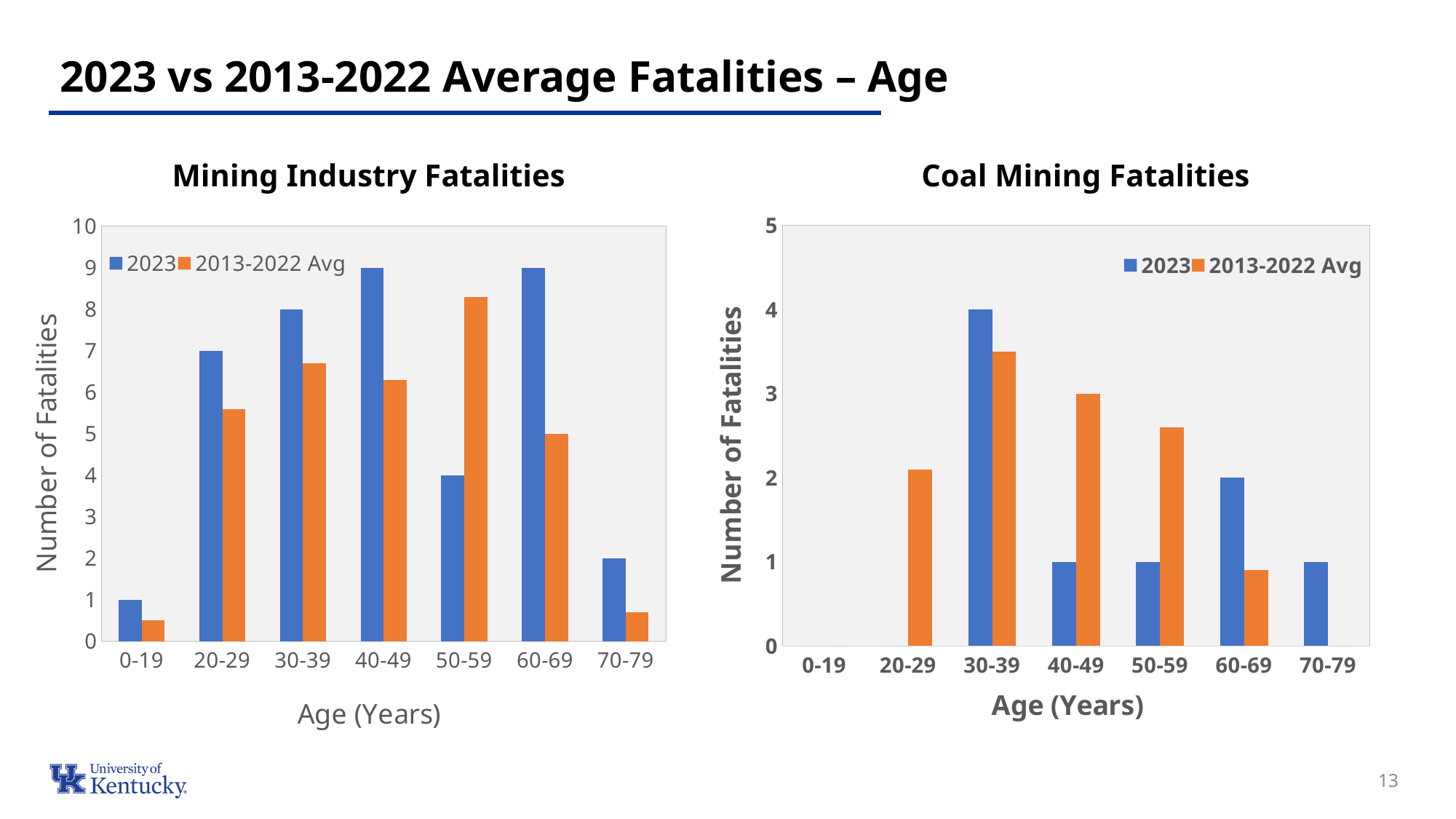
In the Coal Mining Fatalities chart, what is the 2023 value for the 30-39 age group? 4 How many series does the legend of the Mining Industry Fatalities chart list? 2 How many age groups are shown on the x axis of the Coal Mining Fatalities chart? 7 In the Mining Industry Fatalities chart, what is the 2023 value for the 40-49 age group? 9 In the Coal Mining Fatalities chart, which age group has the highest 2023 value? 30-39 In the Mining Industry Fatalities chart, is the 2013-2022 Avg value for the 50-59 age group greater or less than 8? greater In the Mining Industry Fatalities chart, what is the difference between the 2023 values for the 40-49 and 50-59 age groups? 5 In the Mining Industry Fatalities chart, for the 50-59 age group, which is larger: the 2023 value or the 2013-2022 Avg value? 2013-2022 Avg In the Mining Industry Fatalities chart, what is the 2023 value for the 50-59 age group? 4 In the Mining Industry Fatalities chart, which age group has the highest 2013-2022 Avg value? 50-59 What kind of chart is the Coal Mining Fatalities chart? bar chart In the Coal Mining Fatalities chart, what is the 2023 value for the 60-69 age group? 2